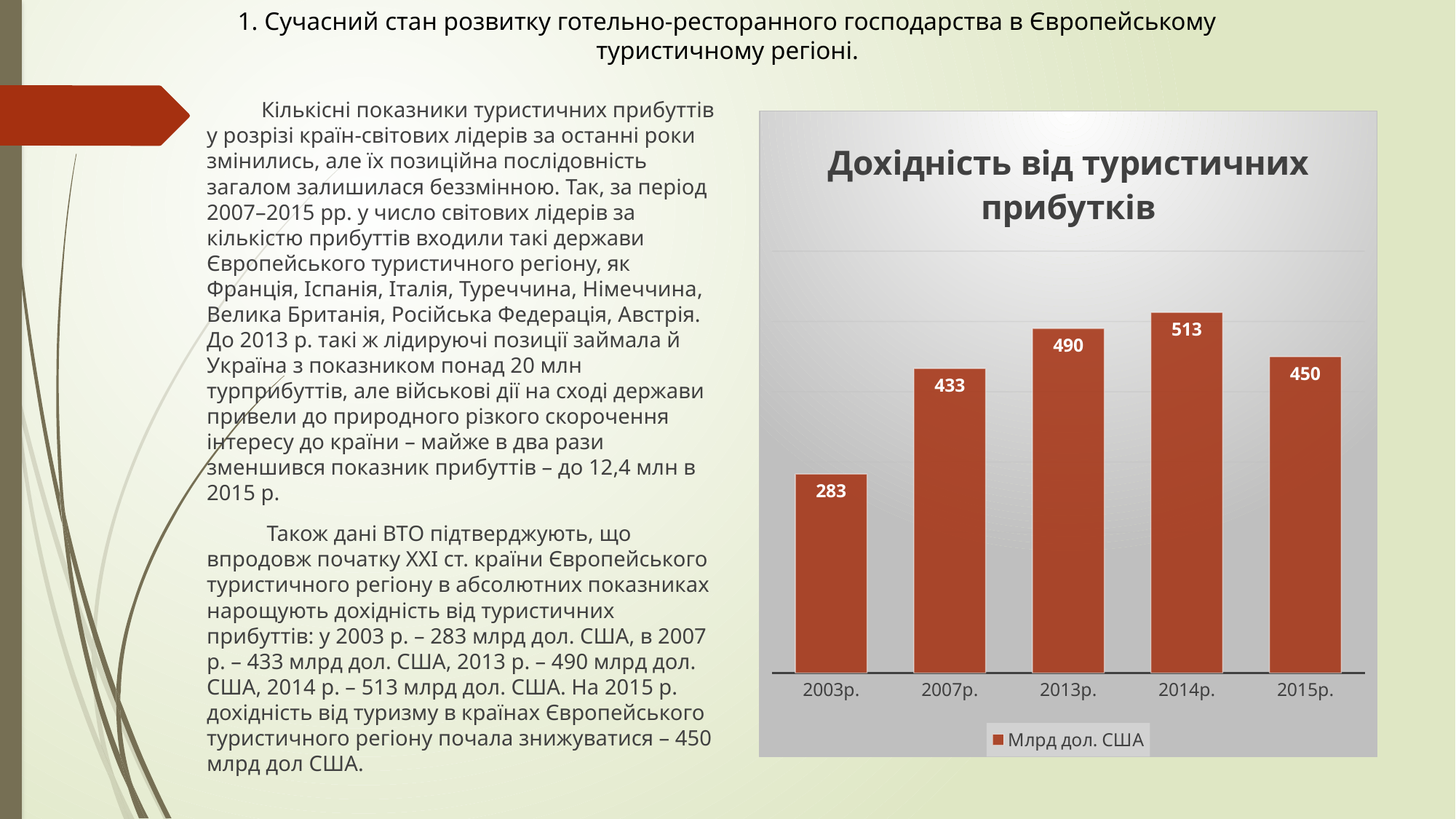
What is the difference between the values for 2014р. and 2015р.? 63 What is the difference between the values for 2007р. and 2003р.? 150 How many series does the legend list? 1 Which is larger, the value for 2013р. or the value for 2015р.? 2013р. Which year has the highest value in the chart? 2014р. Which year has the lowest value in the chart? 2003р. What kind of chart is shown on the slide? bar chart What is the value for 2003р. in the chart? 283 What is the title of the chart? Дохідність від туристичних прибутків What is the value for 2014р. in the chart? 513 What is the value for 2015р. in the chart? 450 How many years are shown in the chart? 5